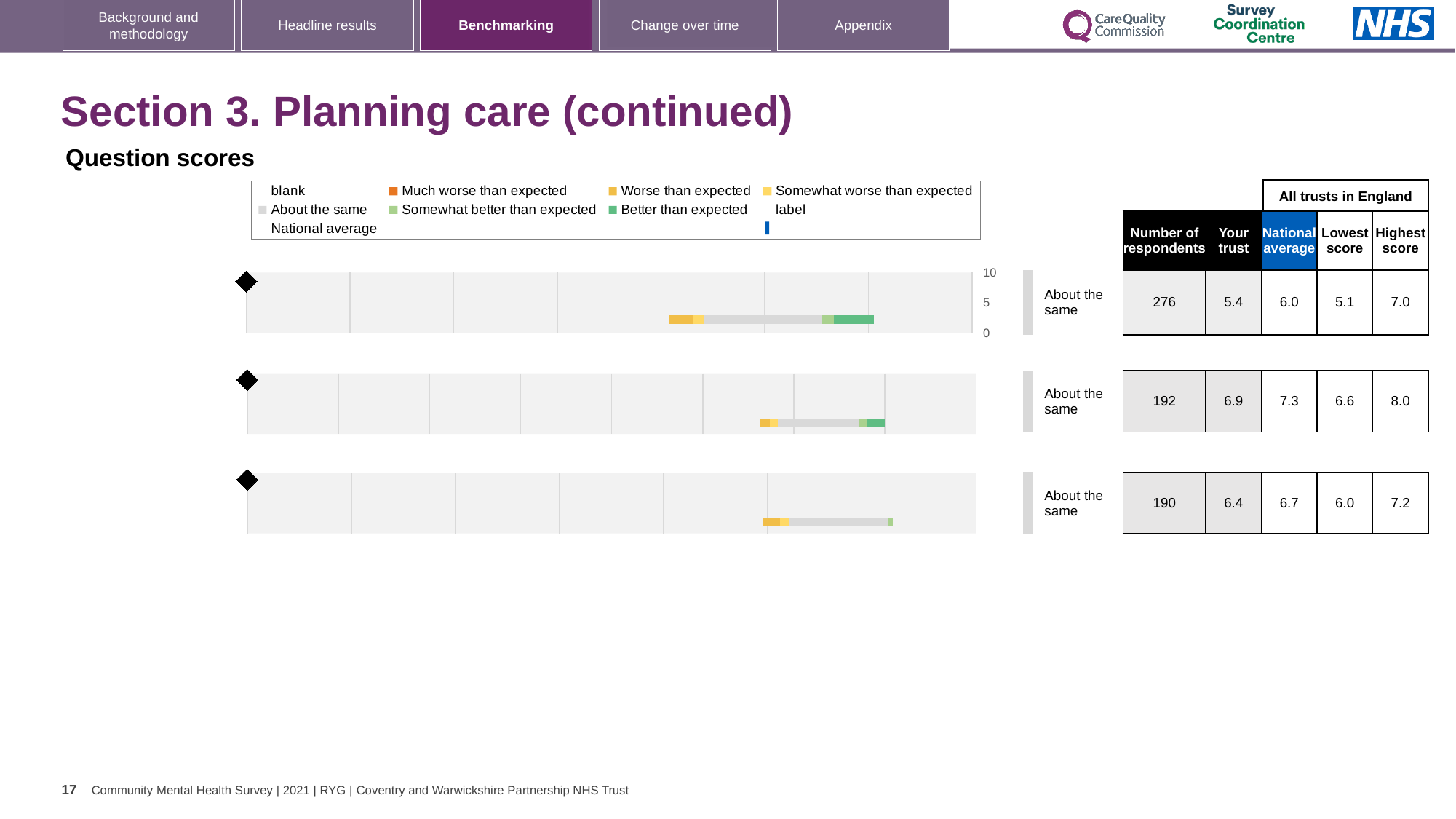
For the top chart, what is the difference between the highest score and the lowest score across all trusts in England? 1.9 For the bottom chart, how many respondents are listed? 190 Which chart row has the highest 'Your trust' score: top, middle or bottom? middle For the top chart, what is the 'Your trust' score shown in the table? 5.4 For the middle chart, what is the national average score? 7.3 What benchmark category is shown next to the top chart? About the same Which chart row has the lowest number of respondents: top, middle or bottom? bottom What kind of chart is used for the three question score rows on the slide? bar chart What is the maximum value shown on the score axis of the top chart? 10 For the bottom chart, is the 'Your trust' score greater or less than 5 on the axis? greater How many question score charts (rows) are shown on the slide? 3 For the middle chart, is the 'Your trust' score or the national average larger? National average